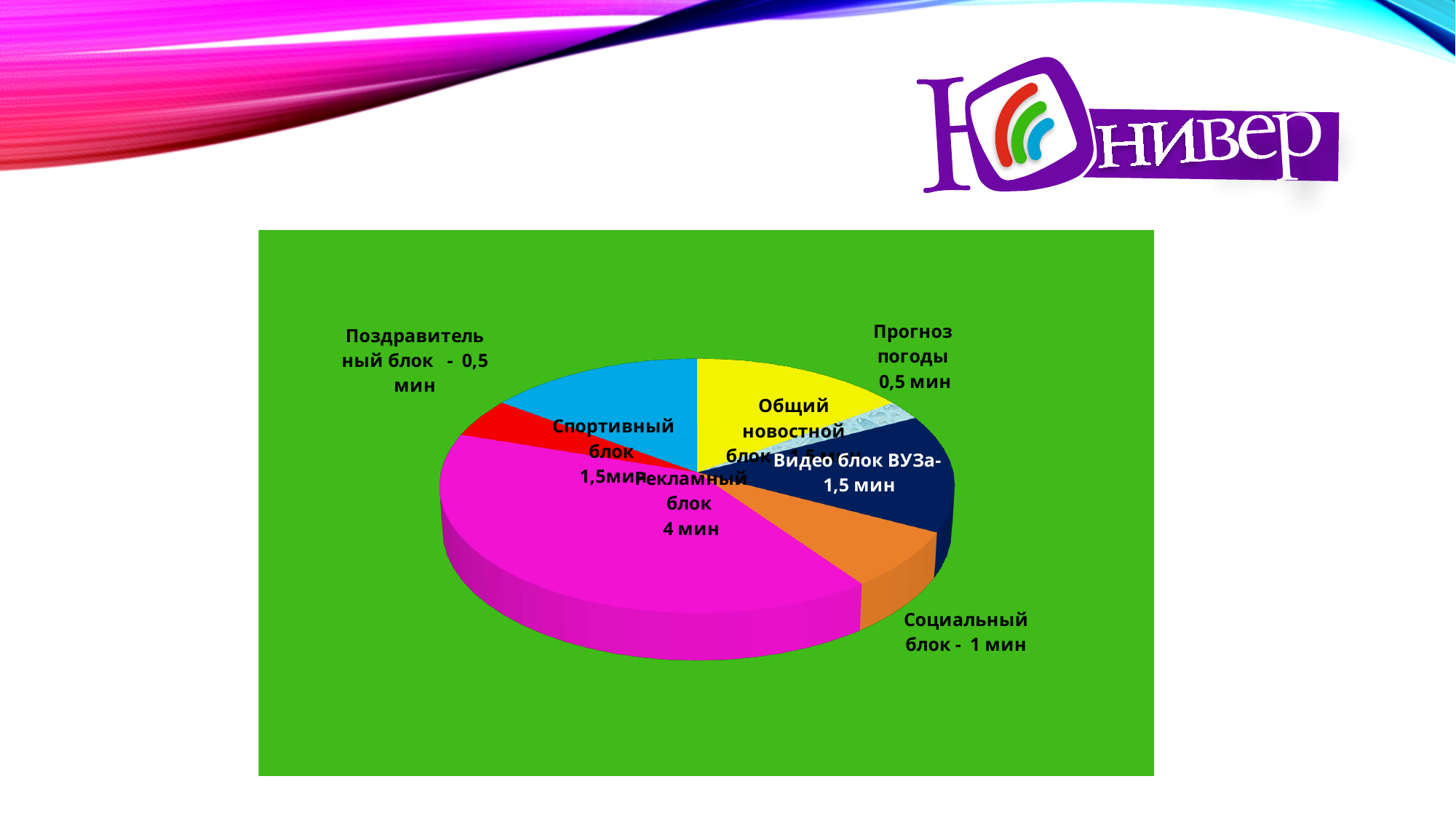
What is the value for Поздравительный блок? 0,5 мин What is the value for Видео блок ВУЗа? 1,5 мин What kind of chart is shown on the slide? pie chart What is the value for Прогноз погоды? 0,5 мин What is the value for Рекламный блок? 4 мин Which block has the largest slice of the pie? Рекламный блок What is the value for Спортивный блок? 1,5мин Which is larger, Рекламный блок or Спортивный блок? Рекламный блок What is the difference between Рекламный блок and Социальный блок? 3 мин How many slices does the pie chart have? 7 What colour is the slice for Рекламный блок? magenta (pink) What is the value for Социальный блок? 1 мин